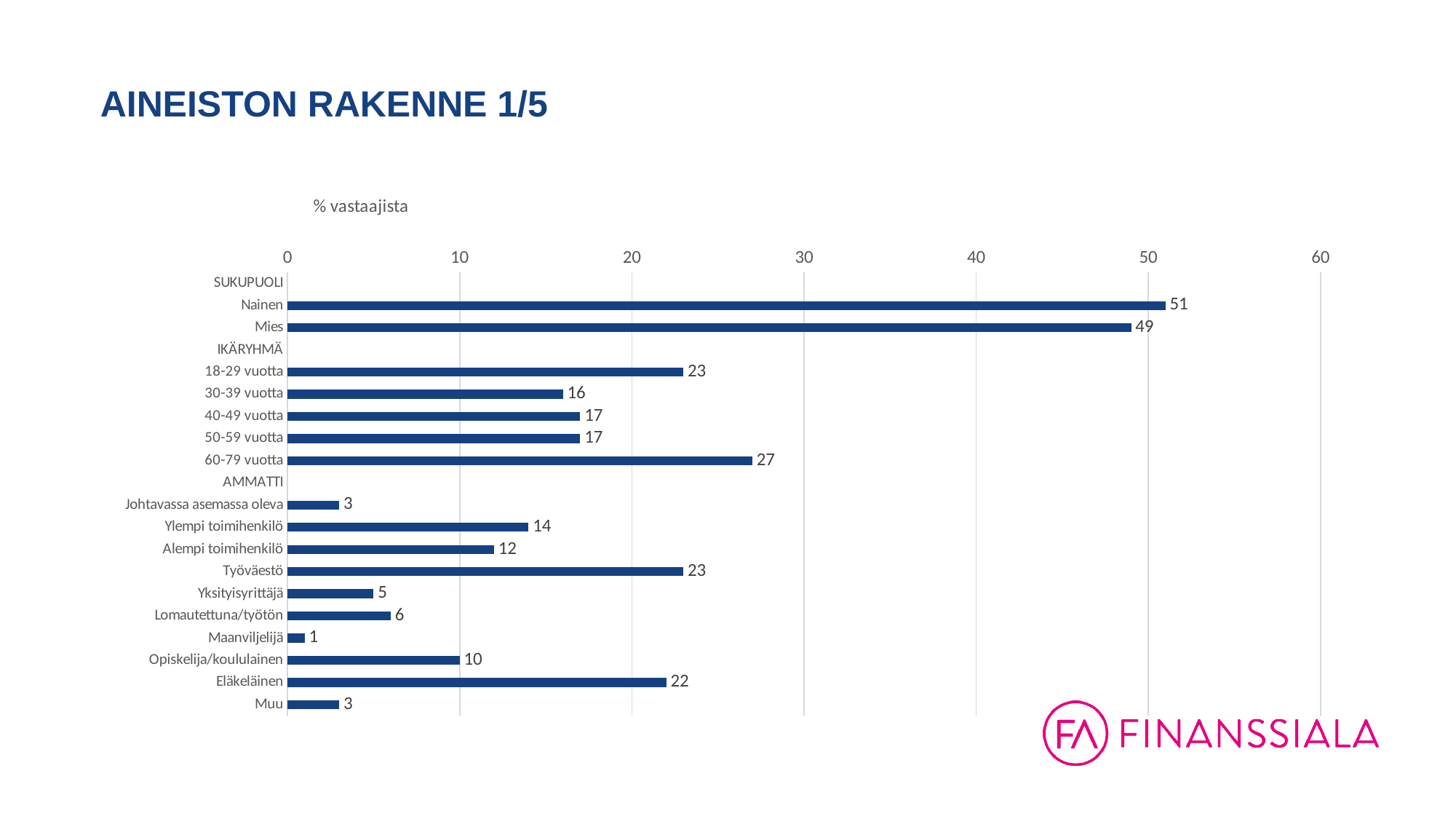
Which is larger, the value for 18-29 vuotta or the value for 30-39 vuotta? 18-29 vuotta What kind of chart is shown on the slide? Bar chart What is the value for 60-79 vuotta? 27 Which category has the highest value in the chart? Nainen What is the value for Opiskelija/koululainen? 10 What is the title of the chart? % vastaajista What is the difference between the values for Ylempi toimihenkilö and Alempi toimihenkilö? 2 What is the value for Nainen? 51 Which category has the lowest value in the chart? Maanviljelijä What is the difference between the values for Nainen and Mies? 2 What is the value for Eläkeläinen? 22 Is the value for Työväestö greater or less than 20? greater